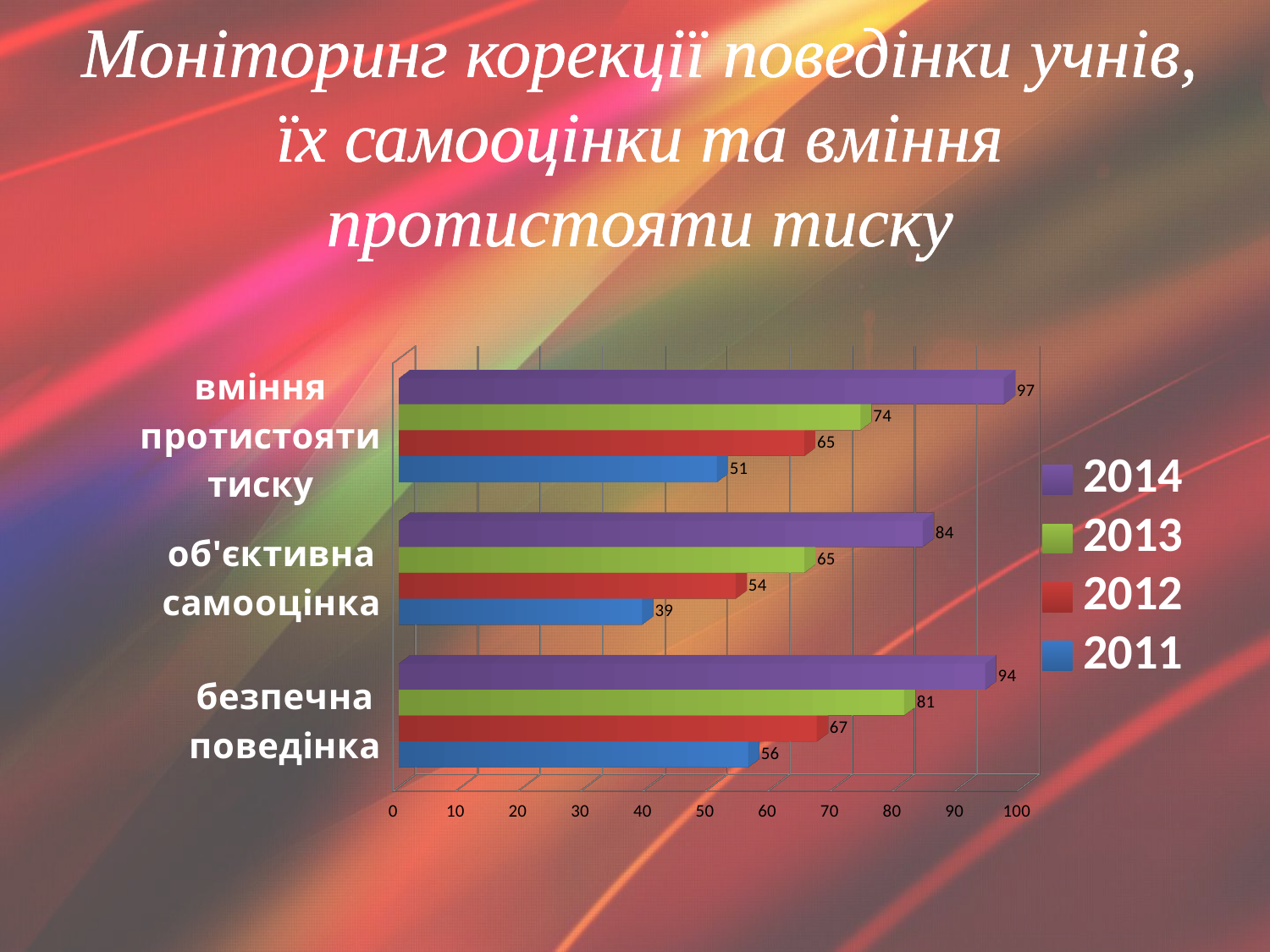
What is the value for 2012 in the category "безпечна поведінка"? 67 Which category has the lowest value for 2011? об'єктивна самооцінка What is the difference between the 2014 and 2011 values for "вміння протистояти тиску"? 46 How many categories are shown on the chart? 3 Which colour represents the 2012 series in the legend? red What is the value for 2013 in the category "об'єктивна самооцінка"? 65 What kind of chart is shown on the slide? bar chart Which category has the highest value for 2014? вміння протистояти тиску What is the value for 2011 in the category "об'єктивна самооцінка"? 39 How many series does the legend list? 4 Which is larger: the 2013 value for "безпечна поведінка" or the 2013 value for "вміння протистояти тиску"? безпечна поведінка What is the value for 2014 in the category "вміння протистояти тиску"? 97